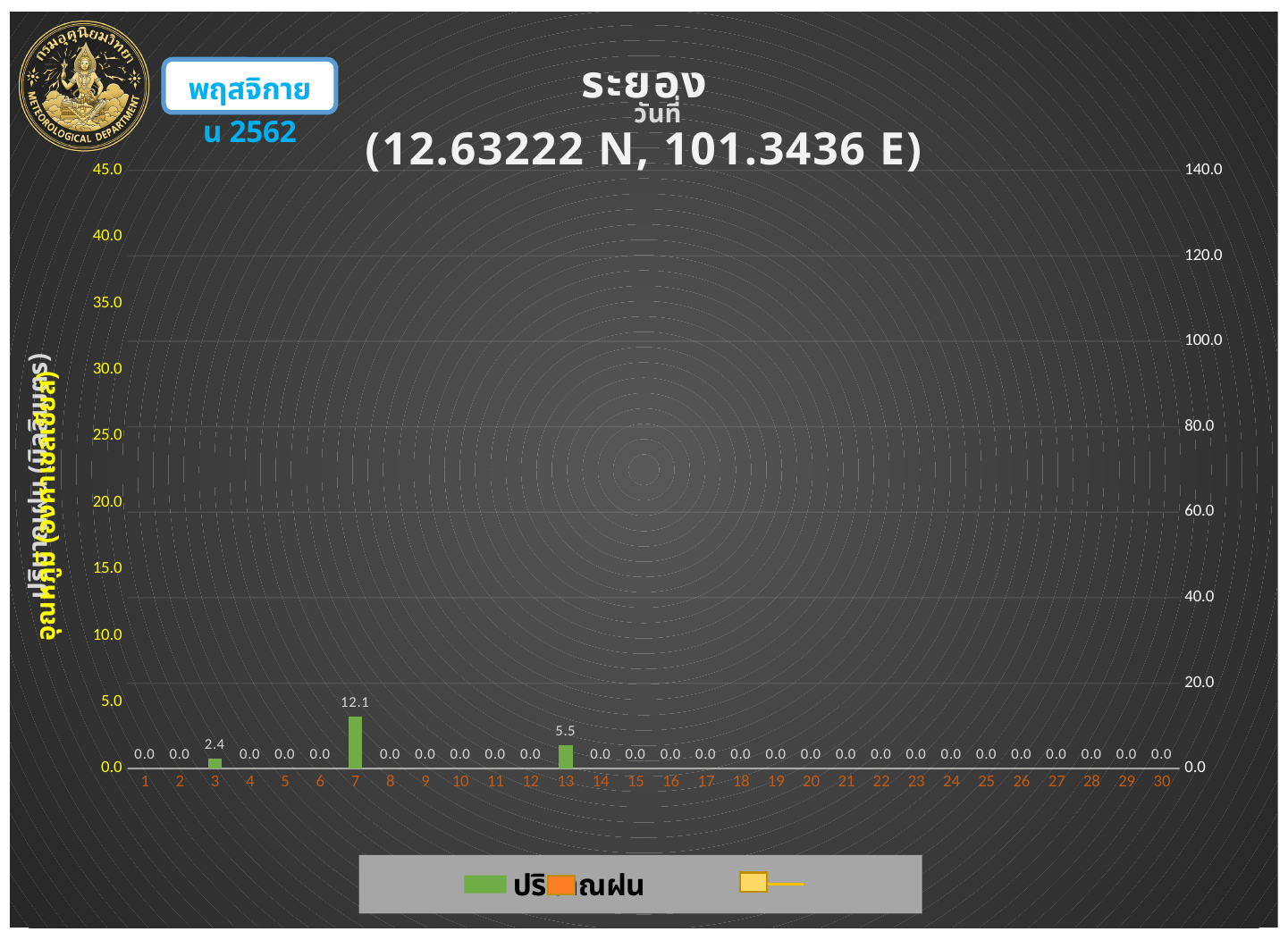
What coordinates are shown under the chart title? (12.63222 N, 101.3436 E) What is the title of the chart? ระยอง What is the value for day 3? 2.4 Which day has the highest value? 7 What is the difference between the values for day 7 and day 13? 6.6 What is the value for day 13? 5.5 Which is larger, the value for day 3 or the value for day 13? day 13 What type of chart is shown on the slide? bar chart What is the value for day 20? 0.0 How many days have a value greater than 0.0? 3 What is the value for day 7? 12.1 How many days (categories) are shown on the x axis? 30